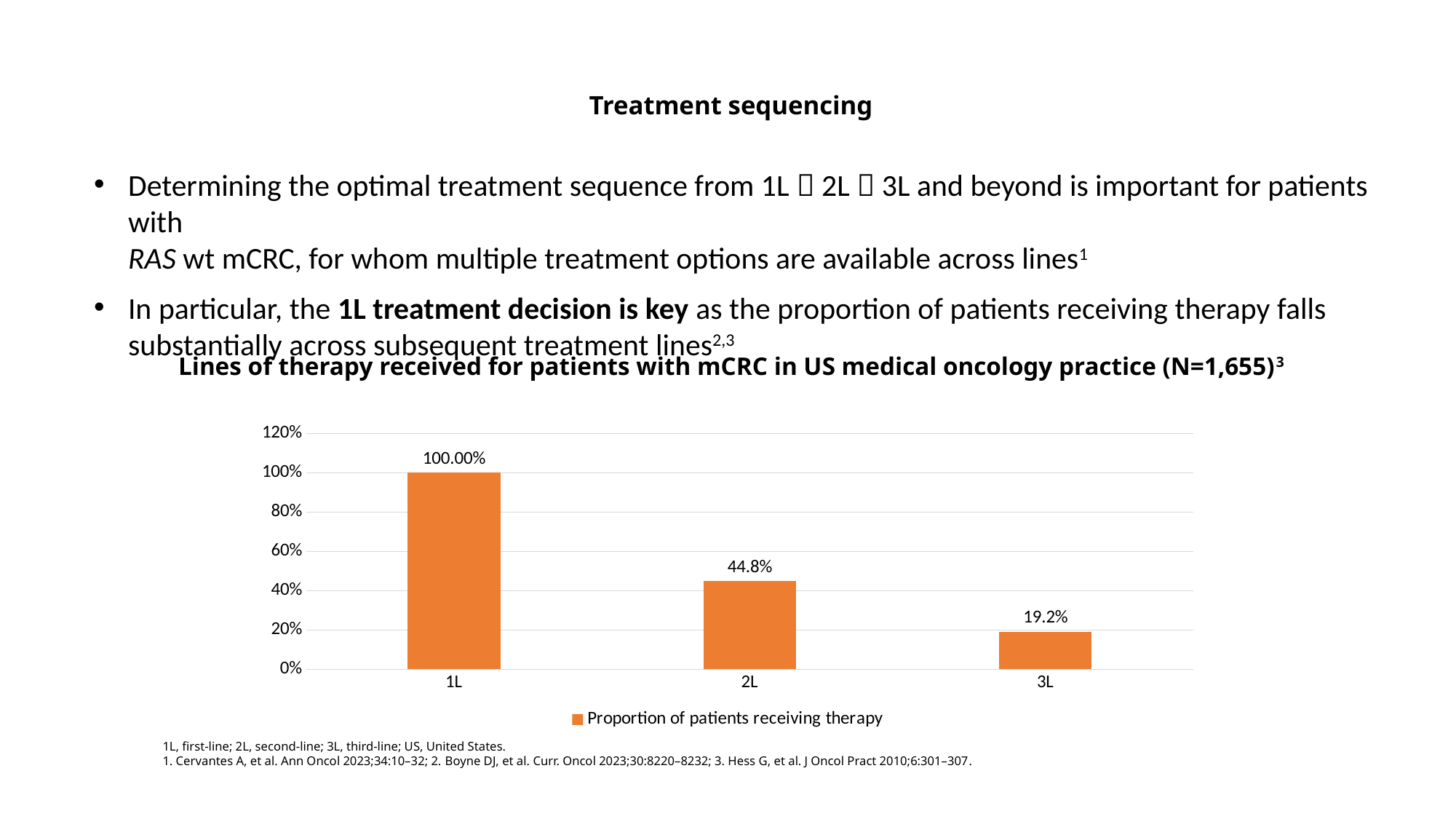
What is the proportion of patients receiving therapy at 2L? 44.8% Do the values rise or fall from 1L to 3L? Fall Is the value for 2L greater or less than 40%? greater How many series does the chart legend list? 1 Which line of therapy has the highest proportion of patients receiving therapy? 1L What is the proportion of patients receiving therapy at 3L? 19.2% Which has a larger proportion of patients receiving therapy, 2L or 3L? 2L How many lines of therapy are shown on the x axis of the chart? 3 Which line of therapy has the lowest proportion of patients receiving therapy? 3L What is the proportion of patients receiving therapy at 1L? 100.00% What is the difference in the proportion of patients receiving therapy between 2L and 3L? 25.6% What kind of chart is shown on the slide? Bar chart